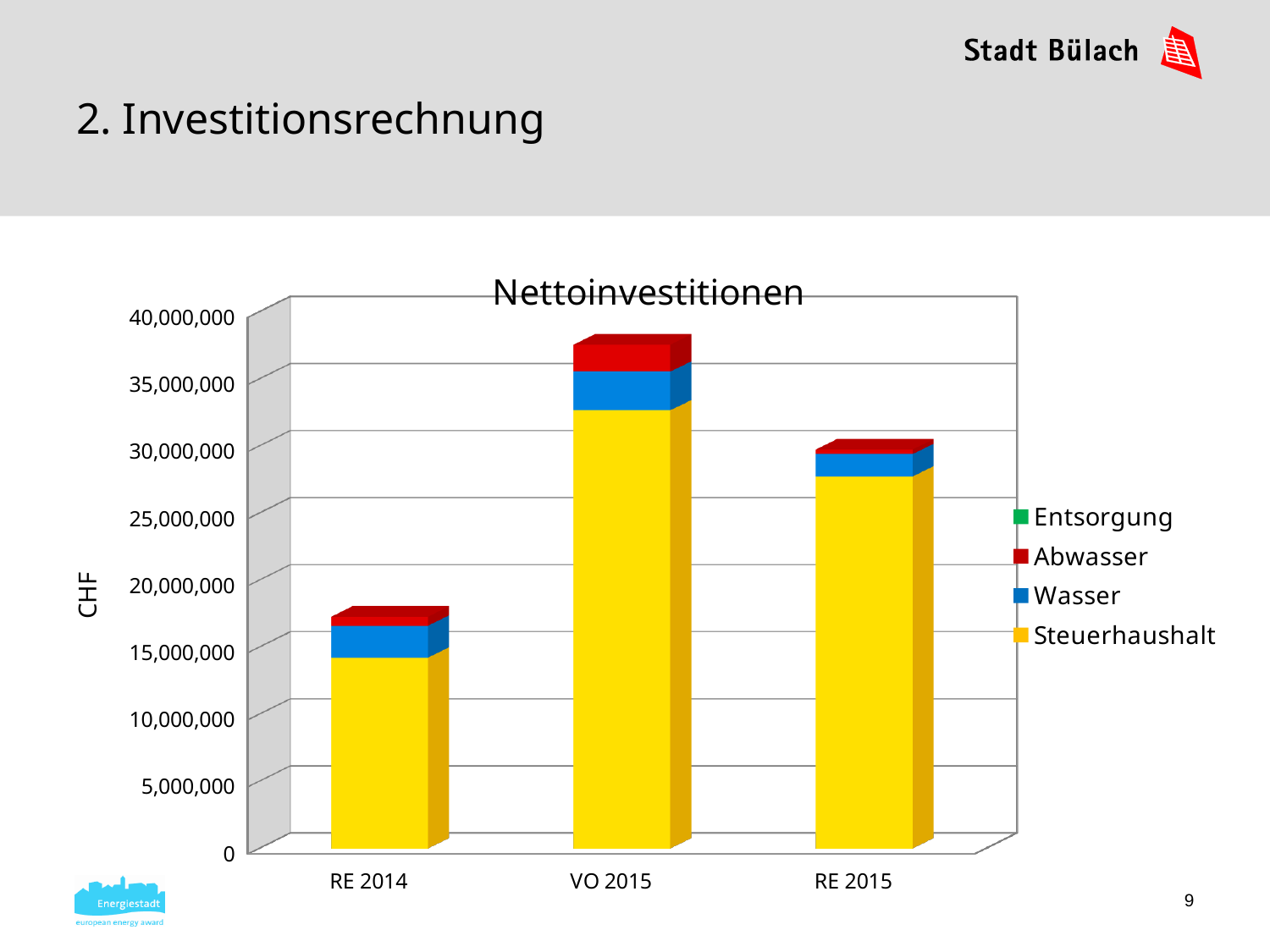
Which has a larger total, VO 2015 or RE 2015? VO 2015 Which category has the highest total net investment? VO 2015 How many categories are shown on the x axis of the chart? 3 Is the Steuerhaushalt value for VO 2015 greater or less than 30,000,000? greater Is the total value for RE 2015 greater or less than 25,000,000? greater How many series does the legend list? 4 What type of chart is shown on the slide? Stacked bar chart What is the title of the chart? Nettoinvestitionen Which category has the lowest total net investment? RE 2014 What unit is shown on the y axis label of the chart? CHF Is the total value for RE 2014 greater or less than 20,000,000? less